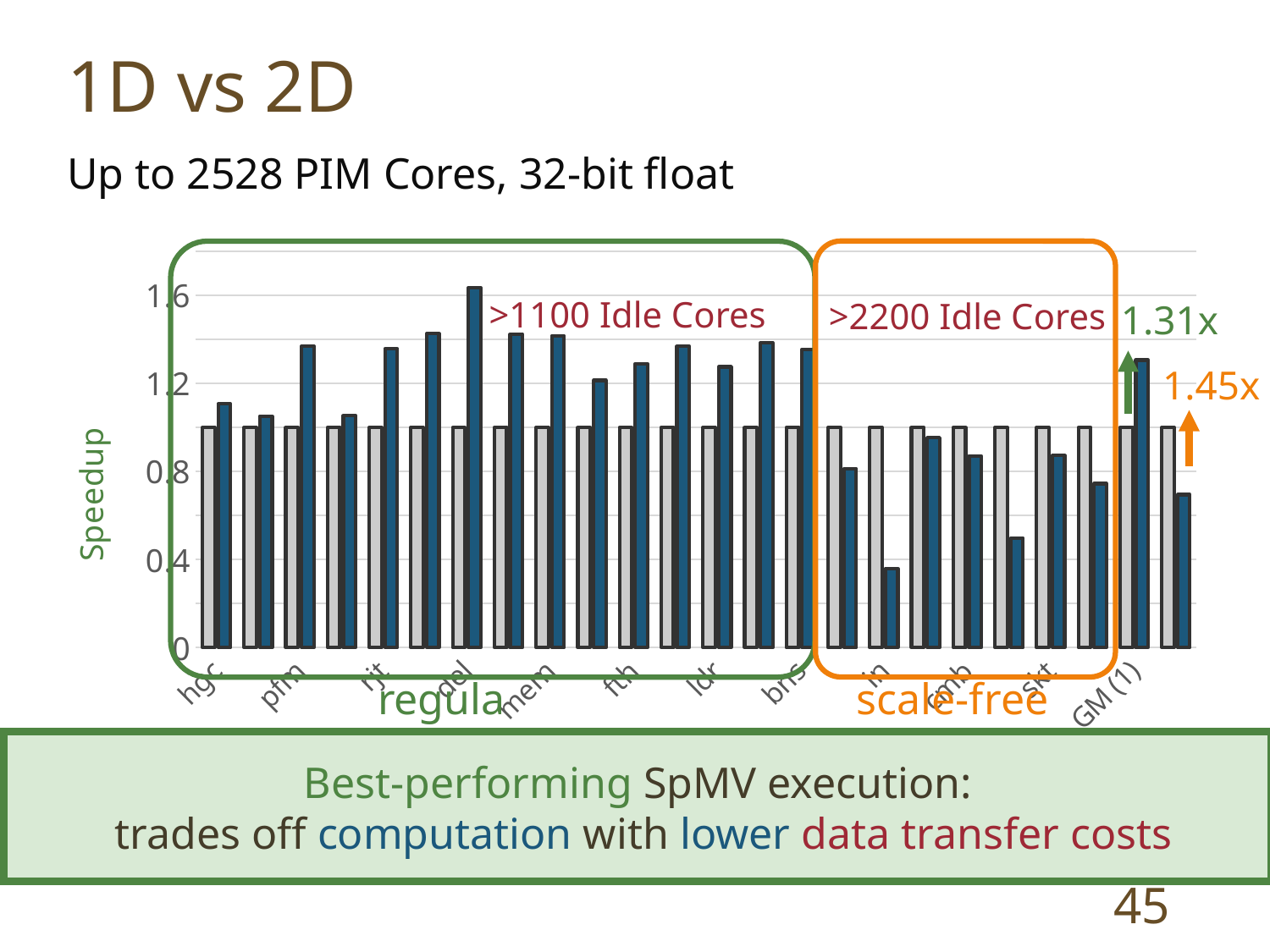
What are the two groups of categories labelled below the x axis? regular and scale-free Is the blue bar for in greater or less than 0.4? less Is the blue bar for hgc greater or less than 0.8? greater Which has the taller blue bar, mem or in? mem Is the blue bar for rjt greater or less than 1.2? greater What is the label of the y axis? Speedup Which has the taller blue bar, del or hgc? del What speedup value is annotated in green next to the GM bars? 1.31x What kind of chart is shown on the slide? bar chart Which category has the tallest blue bar? del